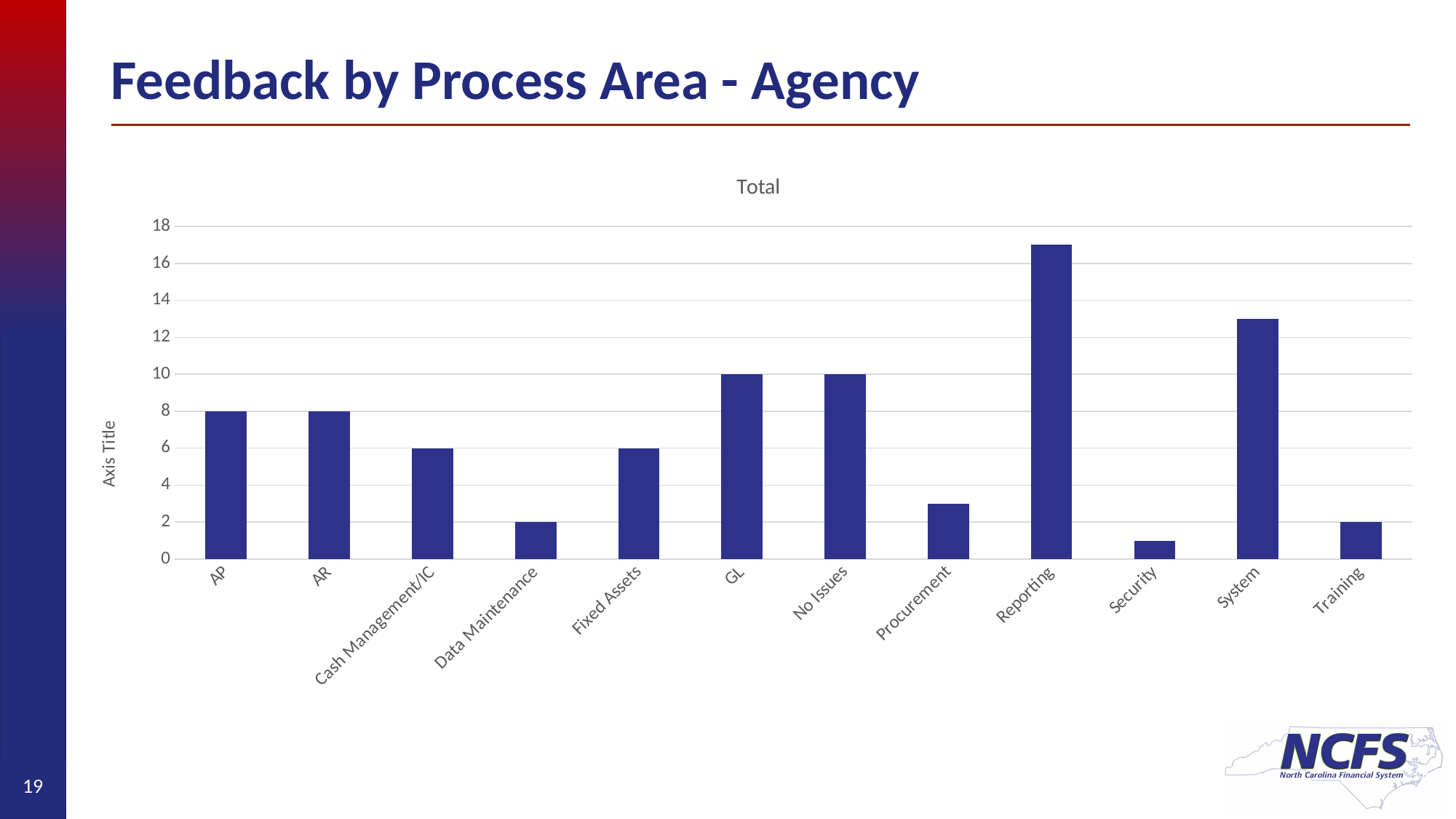
What is the title shown above the chart? Total Which is larger, the value for System or the value for No Issues? System What kind of chart is shown on the slide? Bar chart Is the value for Reporting greater or less than 16? greater What is the difference between the values for GL and Data Maintenance? 8 What is the value for GL? 10 Which process area has the lowest value? Security How many process areas are shown on the x axis? 12 What is the value for Cash Management/IC? 6 Is the value for Procurement greater or less than 4? less Which process area has the highest value? Reporting What is the value for Training? 2